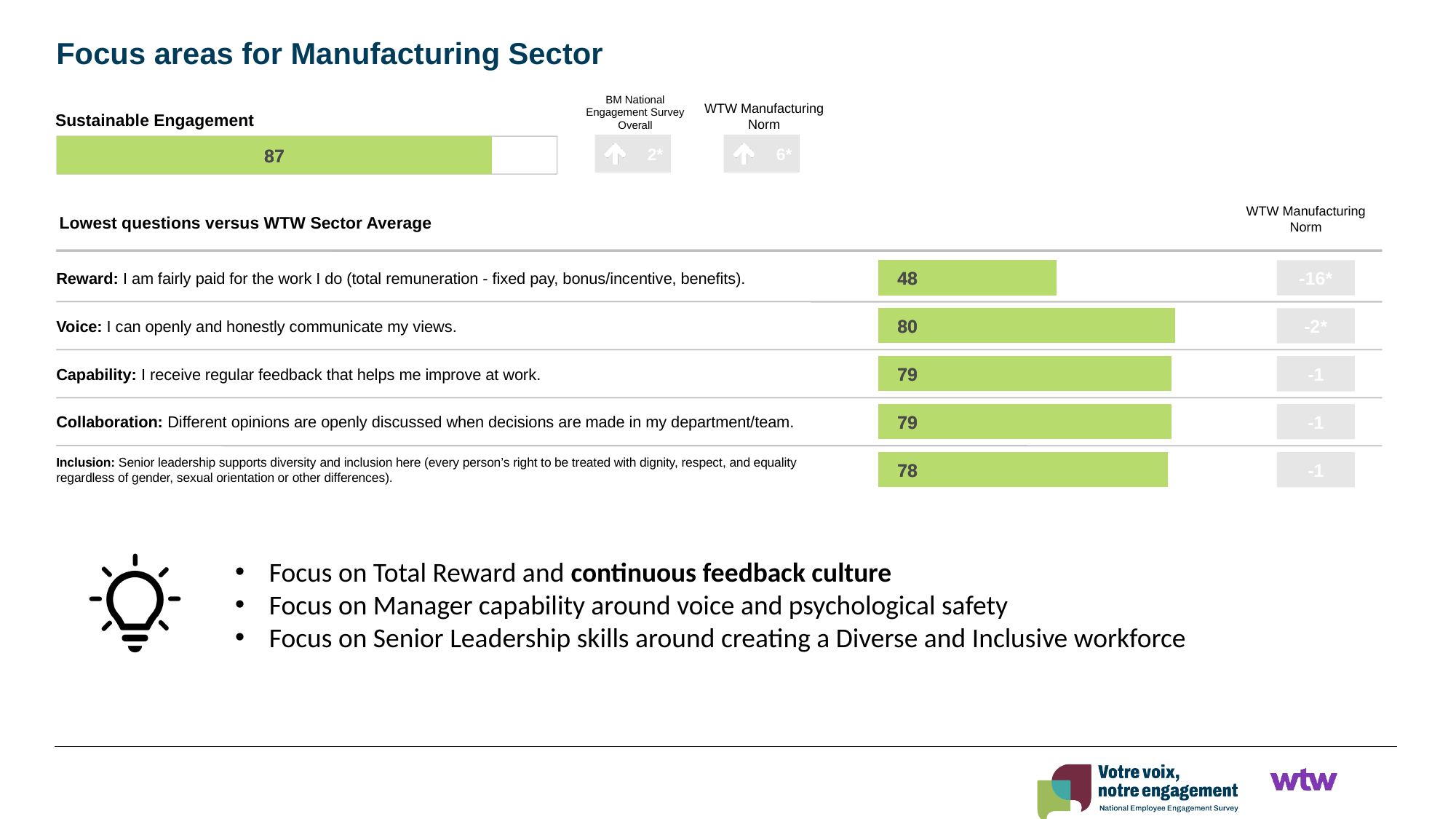
In the Lowest questions versus WTW Sector Average chart, what is the value for Voice? 80 In the Lowest questions versus WTW Sector Average chart, what is the difference between the Voice value and the Reward value? 32 How many questions are shown in the Lowest questions versus WTW Sector Average chart? 5 In the Lowest questions versus WTW Sector Average chart, what is the WTW Manufacturing Norm difference shown for Reward? -16* In the Lowest questions versus WTW Sector Average chart, what is the value for Reward? 48 In the Sustainable Engagement chart, what is the difference shown versus the WTW Manufacturing Norm? 6* In the Lowest questions versus WTW Sector Average chart, which question has the lowest value? Reward In the Lowest questions versus WTW Sector Average chart, which question has the highest value? Voice In the Lowest questions versus WTW Sector Average chart, what is the value for Inclusion? 78 In the Lowest questions versus WTW Sector Average chart, which is larger, the value for Capability or the value for Inclusion? Capability In the Sustainable Engagement chart, what is the Sustainable Engagement score? 87 What kind of chart is used for the Lowest questions versus WTW Sector Average section? Bar chart